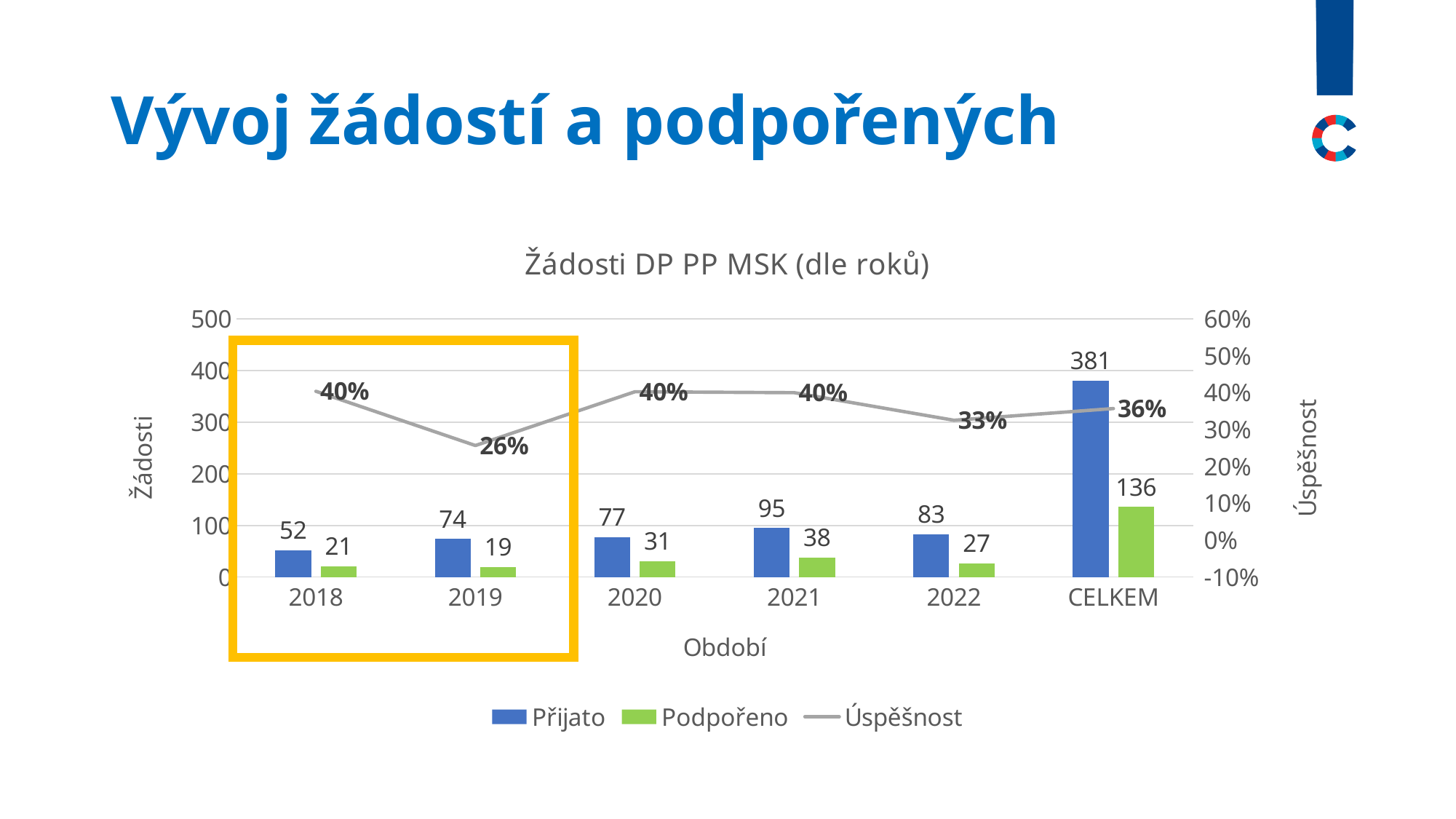
What is the value of Přijato for 2021? 95 What is the value of Podpořeno for 2020? 31 What is the title of the chart? Žádosti DP PP MSK (dle roků) How many categories are shown on the x axis? 6 What kind of chart is this? Combined bar and line chart How many series does the legend list? 3 Which is larger, the Podpořeno value for 2021 or for 2020? 2021 Among the years 2018 to 2022, which year has the highest Přijato value? 2021 What is the difference between Přijato and Podpořeno in 2022? 56 Among the years 2018 to 2022, which year has the lowest Podpořeno value? 2019 What is the Úspěšnost value for 2019? 26% What is the Přijato value for CELKEM? 381